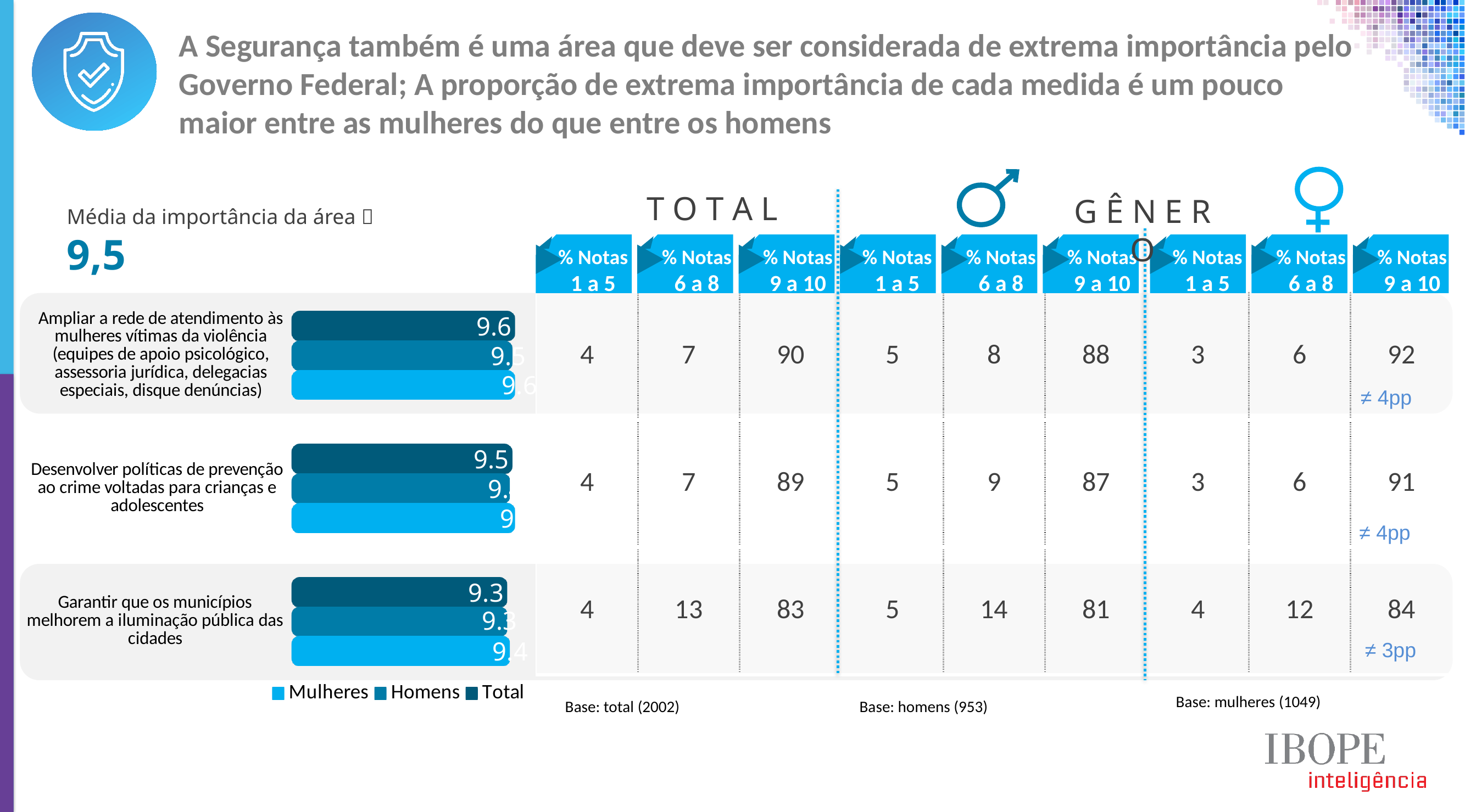
What is the Total value for 'Desenvolver políticas de prevenção ao crime voltadas para crianças e adolescentes'? 9.5 What is the Total value for 'Ampliar a rede de atendimento às mulheres vítimas da violência'? 9.6 How many series does the chart's legend list? 3 Which category has the highest Total value? Ampliar a rede de atendimento às mulheres vítimas da violência Which category has the lowest Total value? Garantir que os municípios melhorem a iluminação pública das cidades What are the three entries in the chart's legend? Mulheres, Homens, Total Which series is shown in the darkest blue bars? Total Which has the larger Total value: 'Desenvolver políticas de prevenção ao crime' or 'Garantir que os municípios melhorem a iluminação pública'? Desenvolver políticas de prevenção ao crime What is the Total value for 'Garantir que os municípios melhorem a iluminação pública das cidades'? 9.3 What kind of chart is shown on the slide? Bar chart What is the difference between the Total values for 'Ampliar a rede de atendimento às mulheres vítimas da violência' and 'Garantir que os municípios melhorem a iluminação pública das cidades'? 0.3 How many categories (measures) are plotted in the bar chart? 3